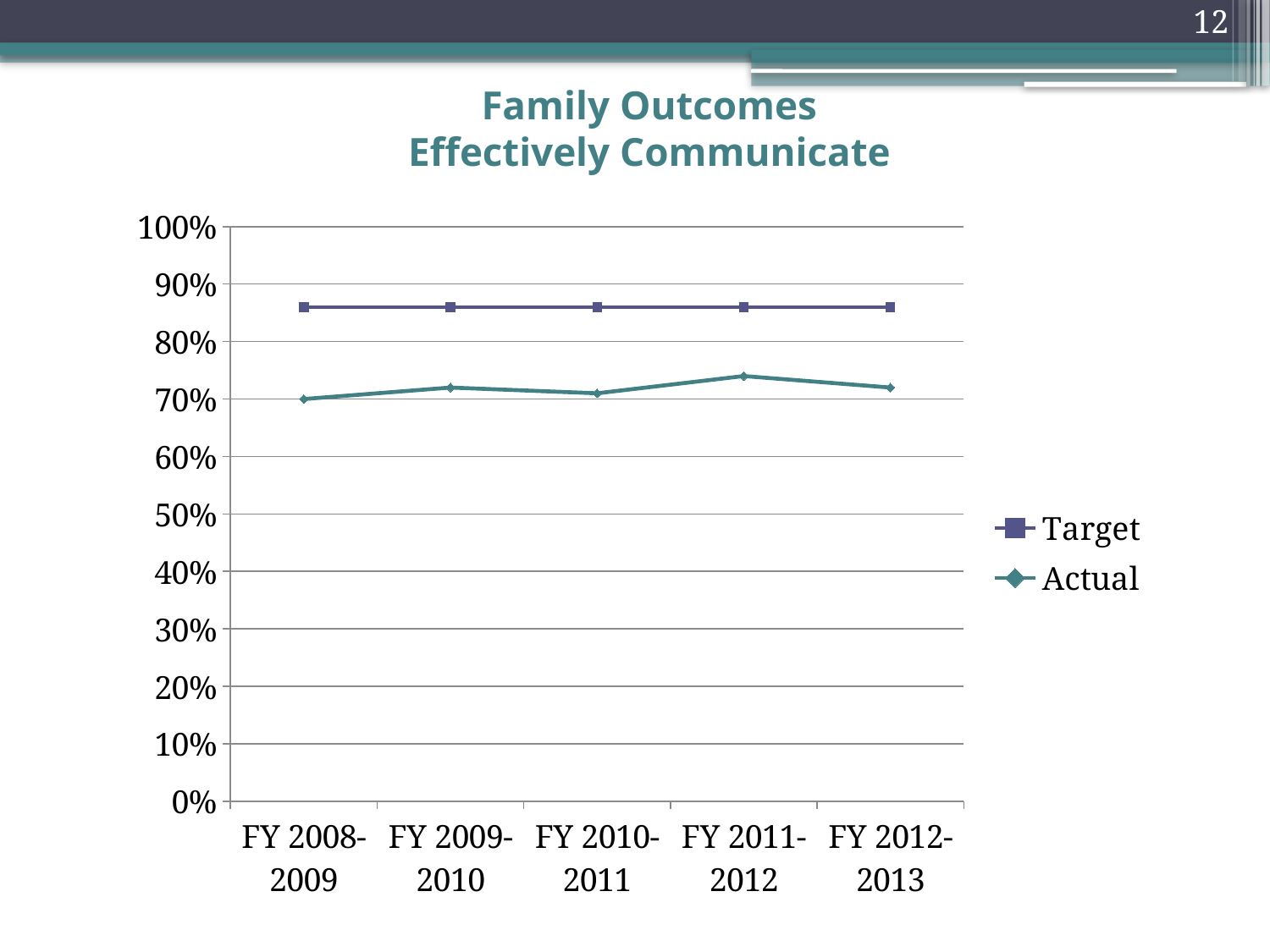
How many series does the legend list? 2 Does the Target series rise, fall, or stay flat across the fiscal years? Stays flat Is the Target value for FY 2008-2009 greater or less than 80%? greater Is the Actual value for FY 2009-2010 greater or less than 60%? greater How many fiscal years are plotted along the x axis? 5 What kind of chart is shown on the slide? Line chart Is the Target value for FY 2012-2013 greater or less than 90%? less Which series is higher in FY 2010-2011, Target or Actual? Target In which fiscal year is the Actual value highest? FY 2011-2012 Which series is drawn with square markers? Target What is the title of the chart? Family Outcomes Effectively Communicate